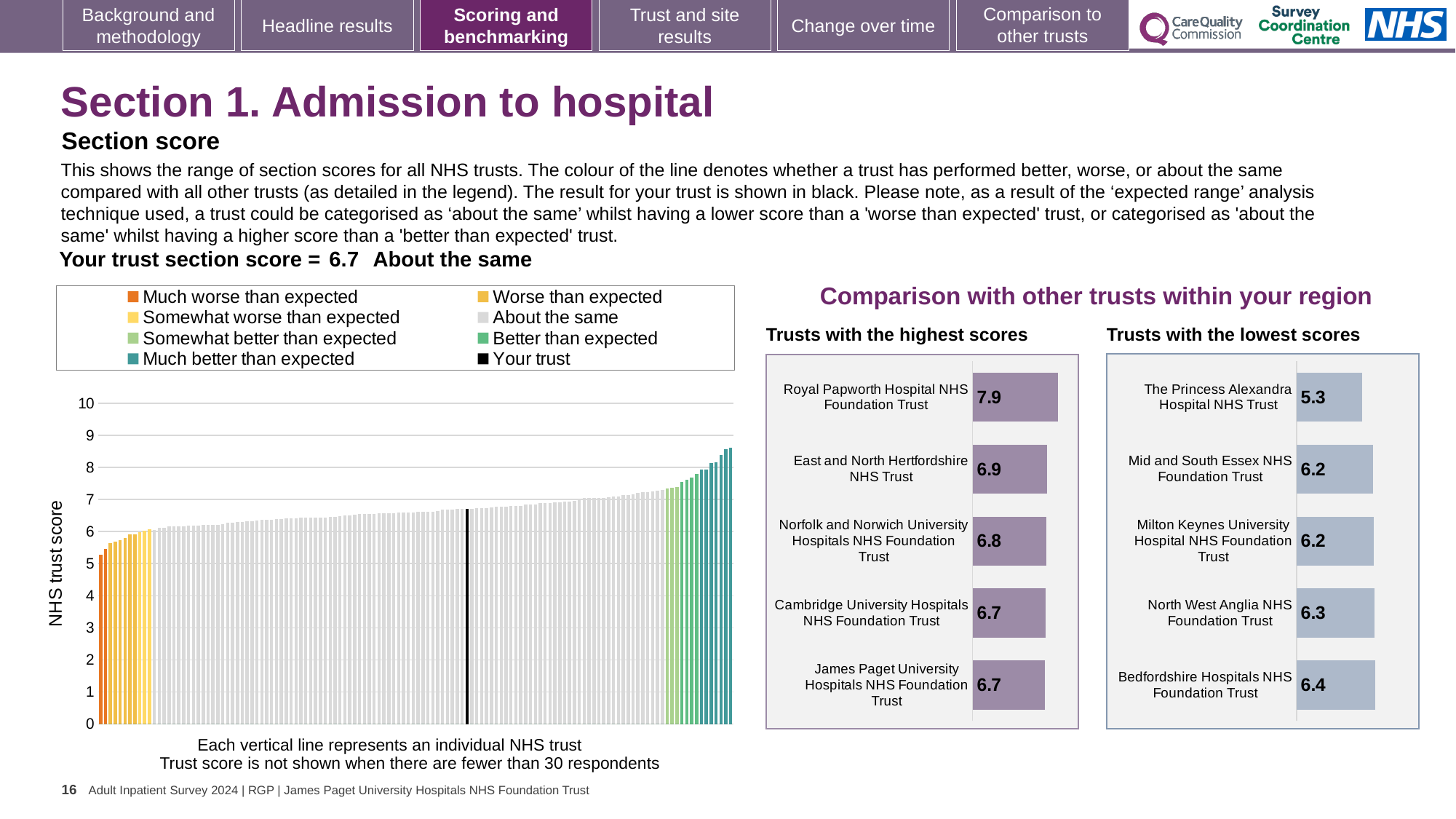
In the 'Trusts with the lowest scores' chart, which has the larger score: North West Anglia NHS Foundation Trust or Mid and South Essex NHS Foundation Trust? North West Anglia NHS Foundation Trust In the 'Trusts with the highest scores' chart, what is the difference between the scores of Royal Papworth Hospital NHS Foundation Trust and East and North Hertfordshire NHS Trust? 1.0 In the 'Trusts with the lowest scores' chart, which trust has the lowest score? The Princess Alexandra Hospital NHS Trust In the 'Trusts with the lowest scores' chart, which trust has the highest score? Bedfordshire Hospitals NHS Foundation Trust In the main chart on the left showing the range of section scores, do the trust scores rise or fall from left to right along the x axis? Rise In the 'Trusts with the lowest scores' chart, what is the score for The Princess Alexandra Hospital NHS Trust? 5.3 In the 'Trusts with the lowest scores' chart, what is the difference between the scores of Bedfordshire Hospitals NHS Foundation Trust and The Princess Alexandra Hospital NHS Trust? 1.1 In the main chart on the left showing the range of section scores, how many entries does the legend list? 8 In the 'Trusts with the highest scores' chart, which trust has the highest score? Royal Papworth Hospital NHS Foundation Trust In the main chart on the left showing the range of section scores, what kind of chart is it? Bar chart In the 'Trusts with the highest scores' chart, what is the score for Royal Papworth Hospital NHS Foundation Trust? 7.9 In the 'Trusts with the highest scores' chart, how many trusts are shown? 5